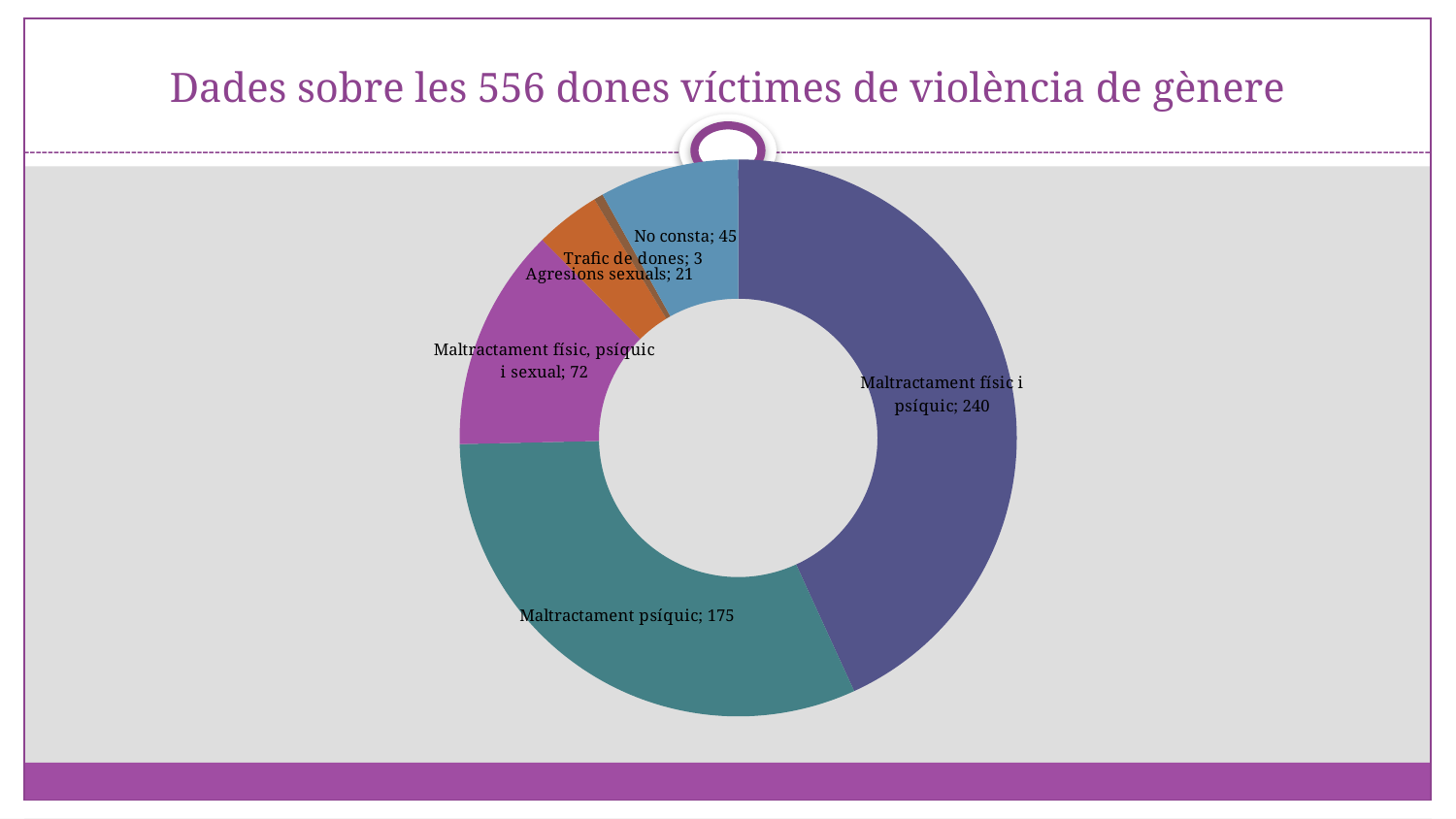
What kind of chart is shown on the slide? Doughnut (pie) chart Which category has the smallest value? Trafic de dones How many categories does the chart show? 6 What is the value for "Maltractament psíquic"? 175 What is the value for "Maltractament físic, psíquic i sexual"? 72 What is the title of the slide? Dades sobre les 556 dones víctimes de violència de gènere What is the value for "Trafic de dones"? 3 Which category has the largest value? Maltractament físic i psíquic What is the value for "No consta"? 45 What is the value for "Maltractament físic i psíquic"? 240 What is the difference between the values for "Maltractament físic i psíquic" and "Maltractament psíquic"? 65 Which is larger, the value for "Agresions sexuals" or the value for "No consta"? No consta